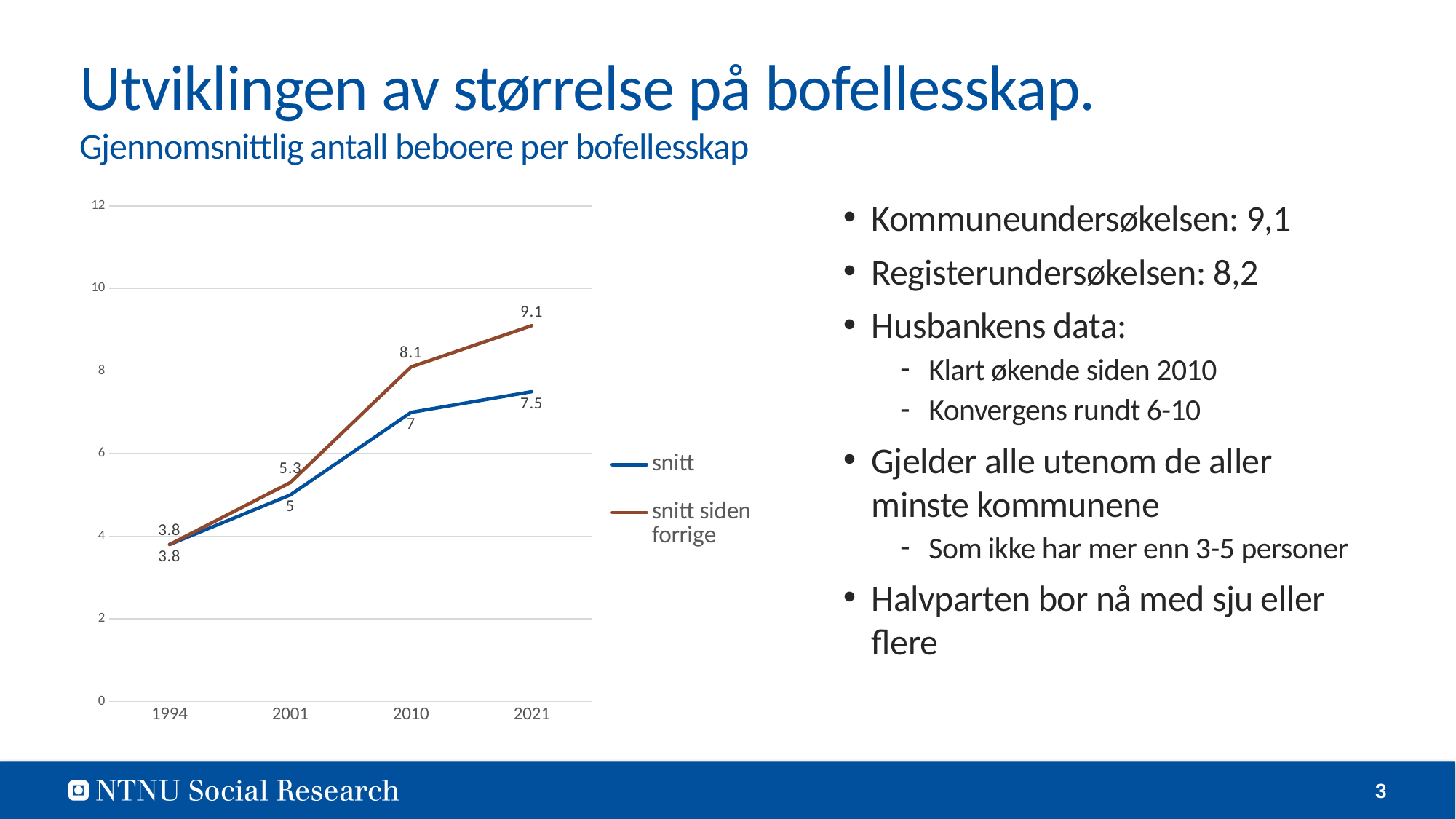
What is the value of the 'snitt siden forrige' series in 2010? 8.1 In which year does the 'snitt siden forrige' series reach its highest value? 2021 What colour is the line for the 'snitt siden forrige' series? brown What is the difference between the 'snitt siden forrige' and 'snitt' values in 2021? 1.6 Which series has the higher value in 2010, 'snitt' or 'snitt siden forrige'? snitt siden forrige What is the value of the 'snitt' series in 2001? 5 What is the value of the 'snitt' series in 2021? 7.5 In which year is the 'snitt' series at its lowest value? 1994 Does the 'snitt' series rise or fall from 1994 to 2021? rise How many years are plotted along the x axis of the chart? 4 What type of chart is shown on the slide? line chart How many series does the chart legend list? 2